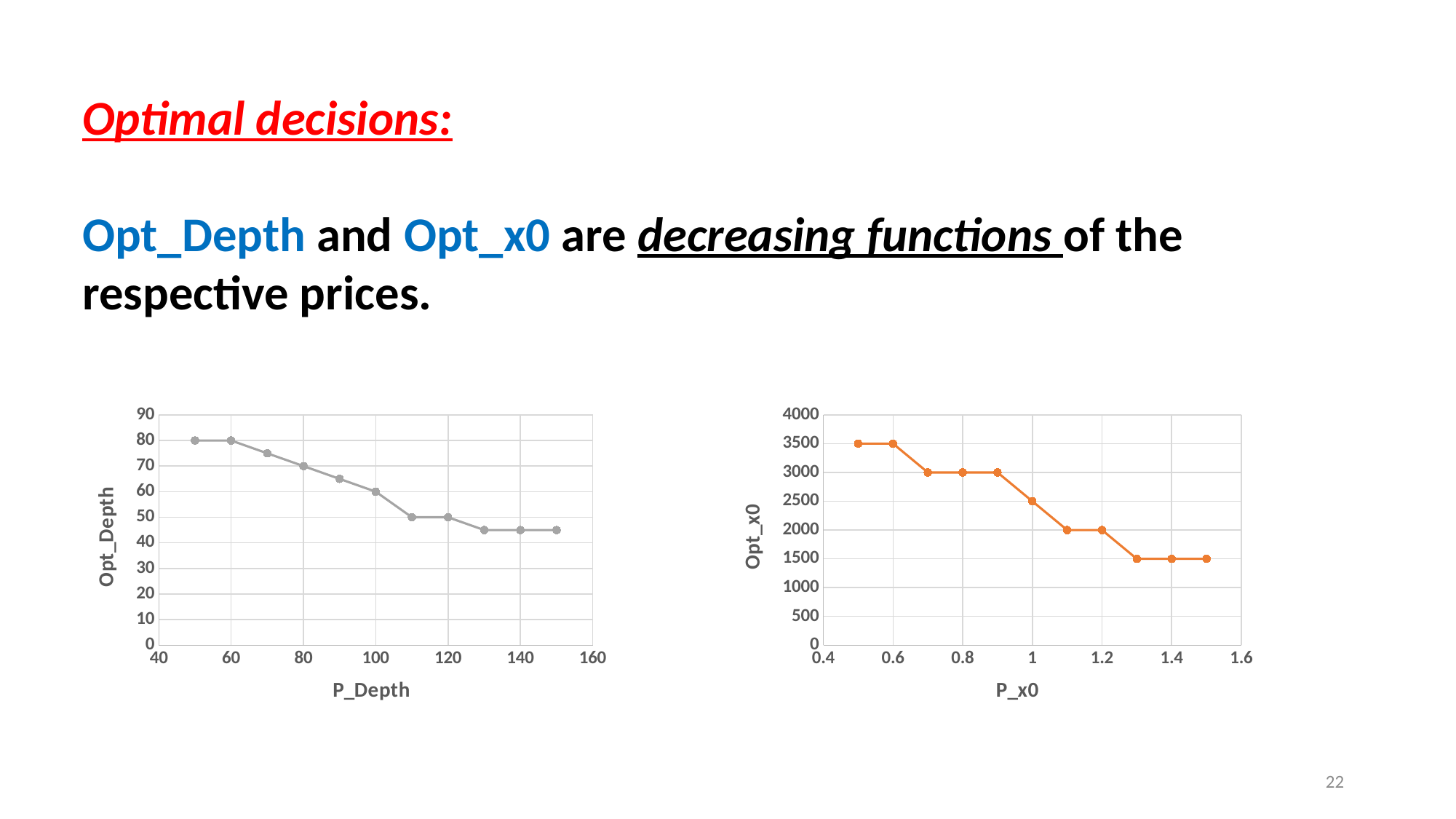
What is the x-axis label of the right chart? P_x0 In the right chart (Opt_x0 vs P_x0), what is Opt_x0 when P_x0 is 0.5? 3500 In the right chart (Opt_x0 vs P_x0), which is larger: Opt_x0 at P_x0 = 0.8 or at P_x0 = 1.2? P_x0 = 0.8 How many data points are plotted in the left chart (Opt_Depth vs P_Depth)? 11 In the left chart (Opt_Depth vs P_Depth), what is Opt_Depth when P_Depth is 50? 80 In the left chart (Opt_Depth vs P_Depth), is the value at P_Depth = 140 greater or less than 50? less What kind of chart is the left chart (Opt_Depth vs P_Depth)? line chart In the right chart (Opt_x0 vs P_x0), what is Opt_x0 when P_x0 is 1.1? 2000 In the left chart (Opt_Depth vs P_Depth), is the value at P_Depth = 70 greater or less than 70? greater In the right chart (Opt_x0 vs P_x0), what is the difference between Opt_x0 at P_x0 = 0.5 and at P_x0 = 1.5? 2000 In the right chart (Opt_x0 vs P_x0), do the values rise or fall as P_x0 increases? fall In the left chart (Opt_Depth vs P_Depth), what is Opt_Depth when P_Depth is 100? 60